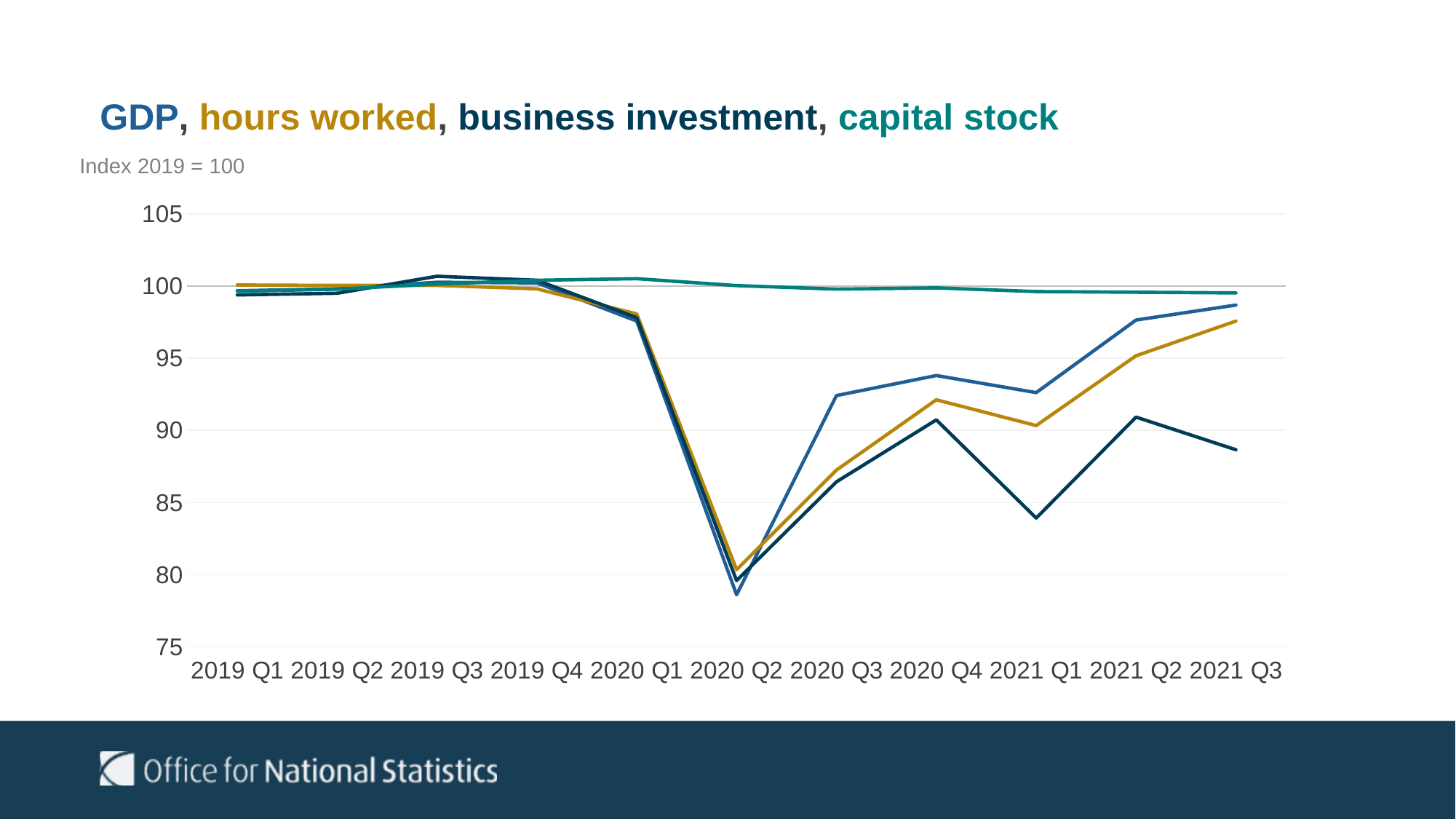
In which quarter does the business investment line reach its lowest point? 2020 Q2 What kind of chart is shown on the slide? line chart Which series stays closest to 100 throughout the whole period? capital stock In 2021 Q3, which is higher: GDP or business investment? GDP How many series does the chart plot? 4 Is the value for business investment in 2021 Q1 greater or less than 85? less What is the index base stated under the title? Index 2019 = 100 How many quarters are plotted along the x axis? 11 Is the value for hours worked in 2021 Q3 greater or less than 95? greater In which quarter does the GDP line reach its lowest point? 2020 Q2 Is the value for GDP in 2020 Q2 greater or less than 80? less Does the business investment line rise or fall between 2020 Q4 and 2021 Q1? fall